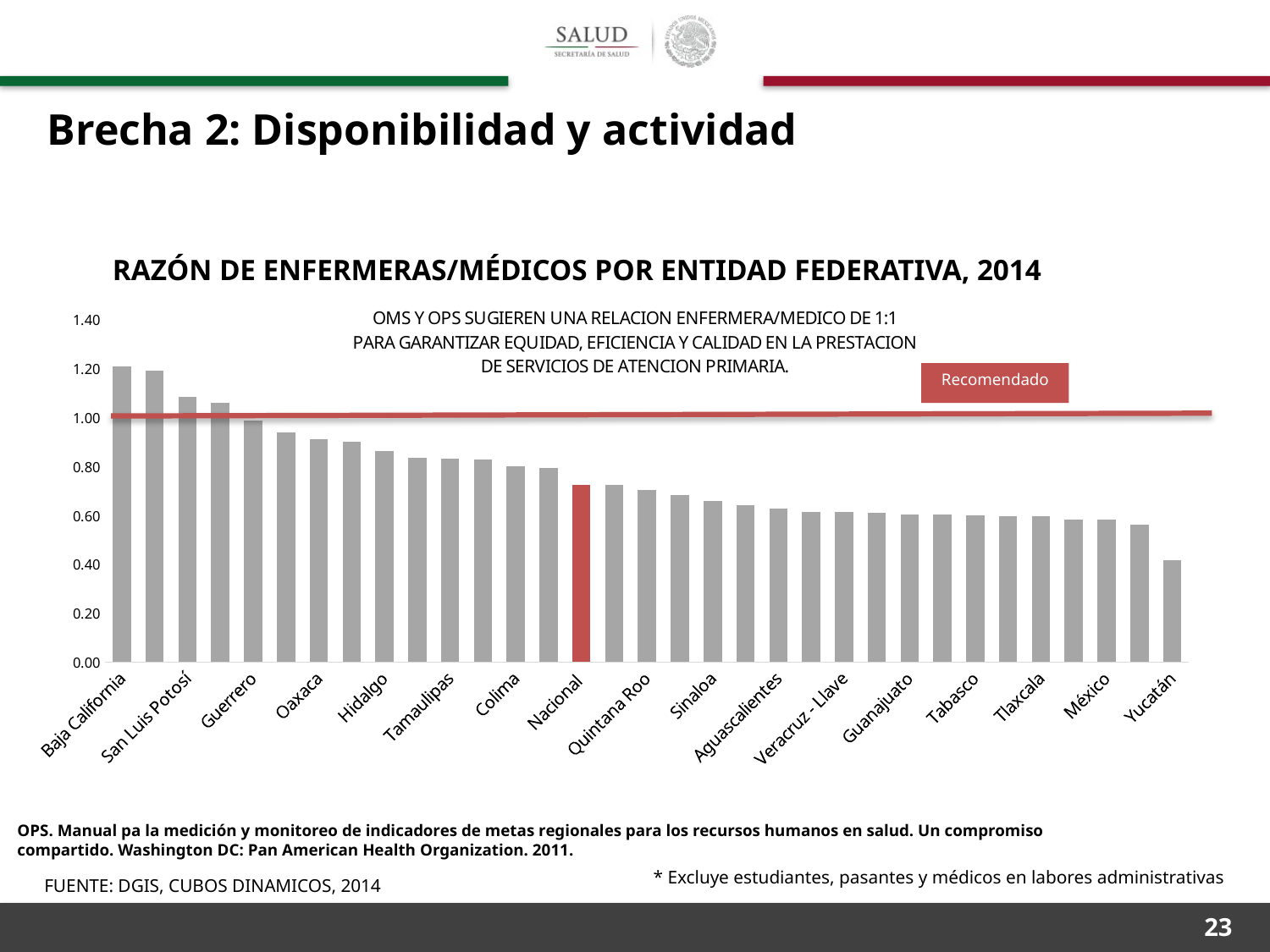
Is the value for Yucatán greater or less than 0.60? less Is the value for Nacional greater or less than 0.80? less What is the title of the chart? RAZÓN DE ENFERMERAS/MÉDICOS POR ENTIDAD FEDERATIVA, 2014 What kind of chart is shown on the slide? bar chart Which category has the lowest value? Yucatán Which has a larger value, Hidalgo or Sinaloa? Hidalgo Which labeled category has the highest value? Baja California Is the value for Baja California greater or less than 1.00? greater Do the values rise or fall moving from left to right along the x axis? fall Which category is highlighted with a red bar? Nacional